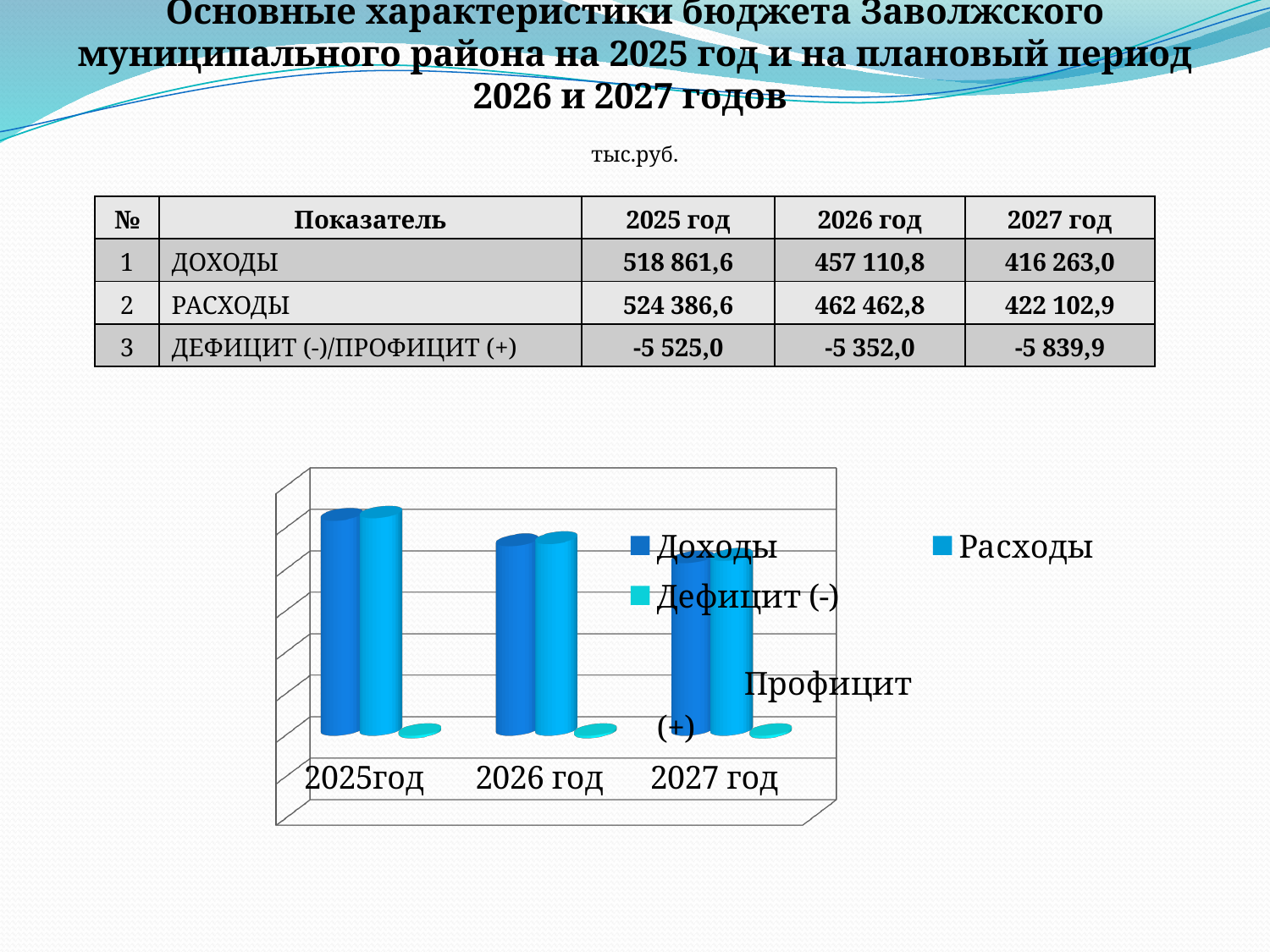
What is the first series listed in the chart legend? Доходы Which is larger in the chart: the Доходы bar for 2025год or the Доходы bar for 2027 год? 2025год Do the Расходы bars rise or fall from 2025 to 2027 in the chart? fall Do the Доходы bars rise or fall from 2025 to 2027 in the chart? fall Which year has the lowest Расходы bar in the chart? 2027 год Which is larger in the chart: the Расходы bar for 2026 год or the Расходы bar for 2027 год? 2026 год Which series in the chart is shown with the smallest bars in every year? Дефицит (-)/Профицит (+) Which year has the highest Доходы bar in the chart? 2025год What kind of chart is shown on the slide? bar chart How many year categories are shown on the x axis of the chart? 3 Which year has the lowest Доходы bar in the chart? 2027 год How many series does the chart legend list? 3